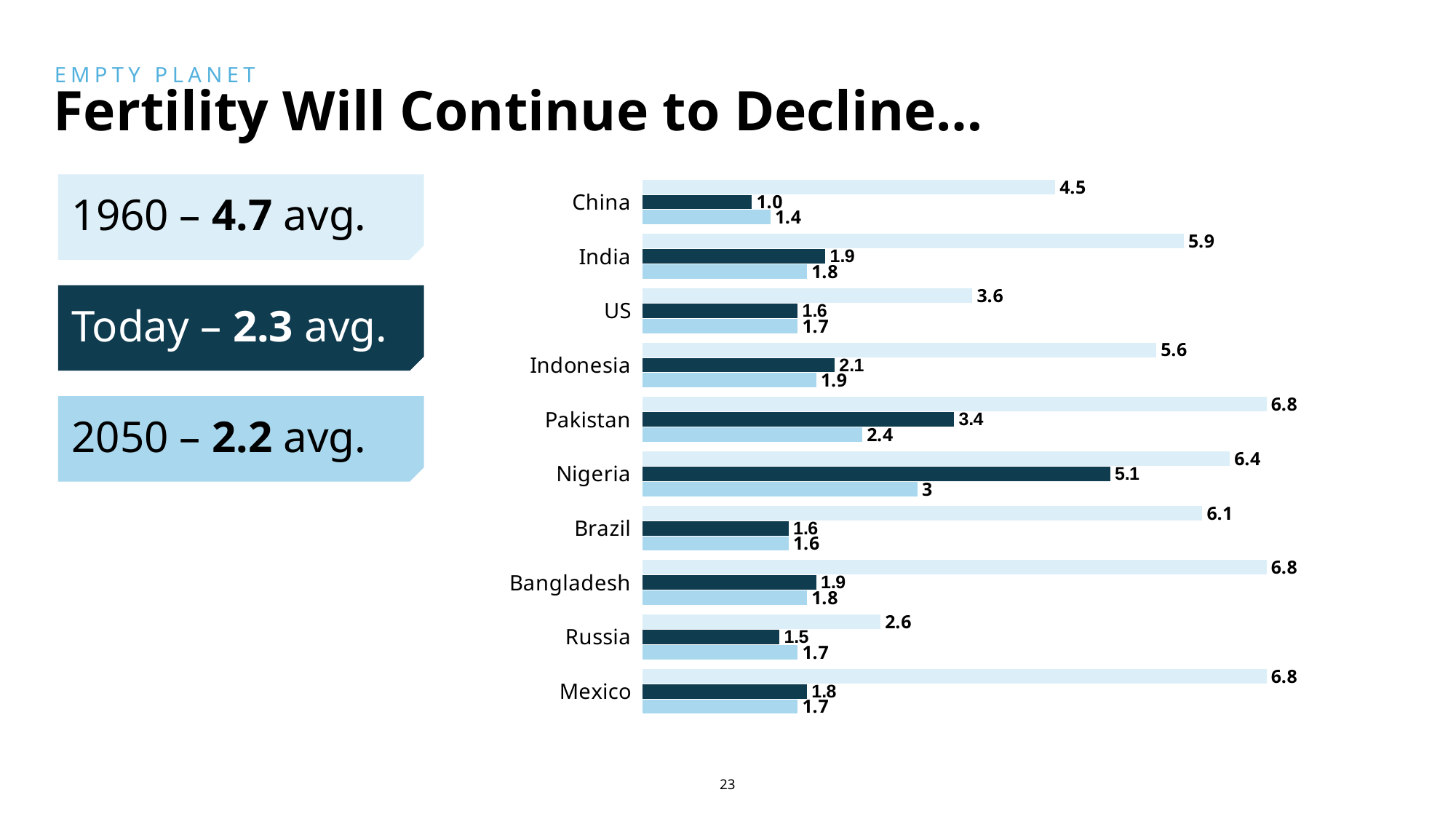
What kind of chart is shown on the slide? bar chart Which country has the highest value for the dark middle bar? Nigeria What is the value of the bottom bar for Pakistan? 2.4 What is the value of the top (palest) bar for India? 5.9 How many countries are listed on the chart? 10 Which country has the lowest value for the top (palest) bar? Russia Which is larger, the dark middle bar for Indonesia or the dark middle bar for US? Indonesia How many bars are plotted for each country on the chart? 3 What is the value of the dark middle bar for China? 1.0 What is the difference between the top (palest) bar and the dark middle bar for Pakistan? 3.4 What is the value of the dark middle bar for Nigeria? 5.1 What is the slide's title? Fertility Will Continue to Decline...